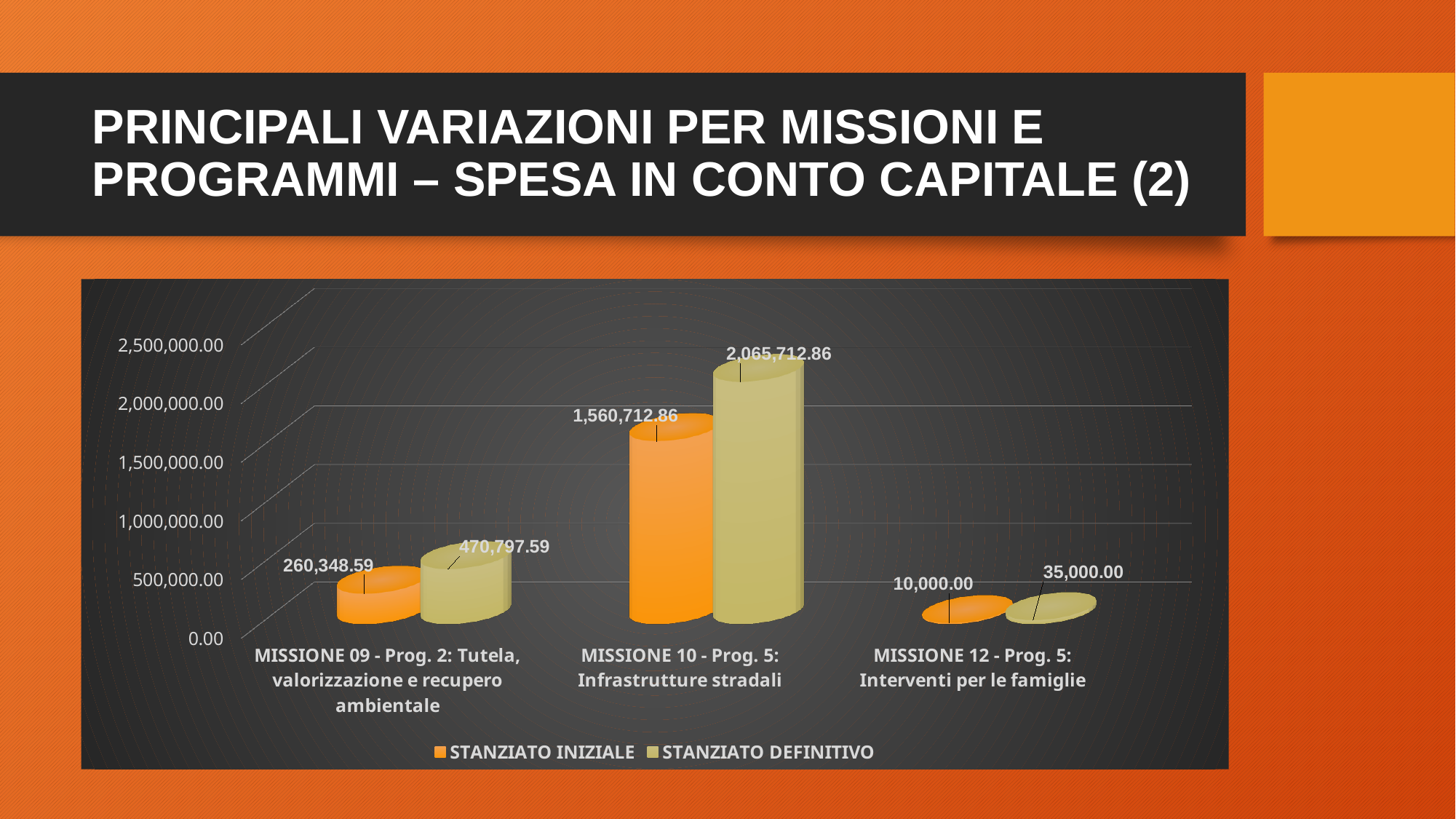
Which category has the lowest STANZIATO INIZIALE value? MISSIONE 12 - Prog. 5: Interventi per le famiglie How many categories are shown on the x axis of the chart? 3 Is the STANZIATO DEFINITIVO value for MISSIONE 10 - Prog. 5 greater or less than 2,000,000.00? greater What is the STANZIATO DEFINITIVO value for MISSIONE 12 - Prog. 5: Interventi per le famiglie? 35,000.00 For MISSIONE 09 - Prog. 2, which is larger: STANZIATO INIZIALE or STANZIATO DEFINITIVO? STANZIATO DEFINITIVO What is the STANZIATO INIZIALE value for MISSIONE 10 - Prog. 5: Infrastrutture stradali? 1,560,712.86 What kind of chart is shown on the slide? Bar chart Which category has the highest STANZIATO DEFINITIVO value? MISSIONE 10 - Prog. 5: Infrastrutture stradali What is the STANZIATO DEFINITIVO value for MISSIONE 09 - Prog. 2: Tutela, valorizzazione e recupero ambientale? 470,797.59 How many series does the chart legend list? 2 What is the difference between STANZIATO DEFINITIVO and STANZIATO INIZIALE for MISSIONE 10 - Prog. 5: Infrastrutture stradali? 505,000.00 What is the difference between STANZIATO DEFINITIVO and STANZIATO INIZIALE for MISSIONE 12 - Prog. 5: Interventi per le famiglie? 25,000.00